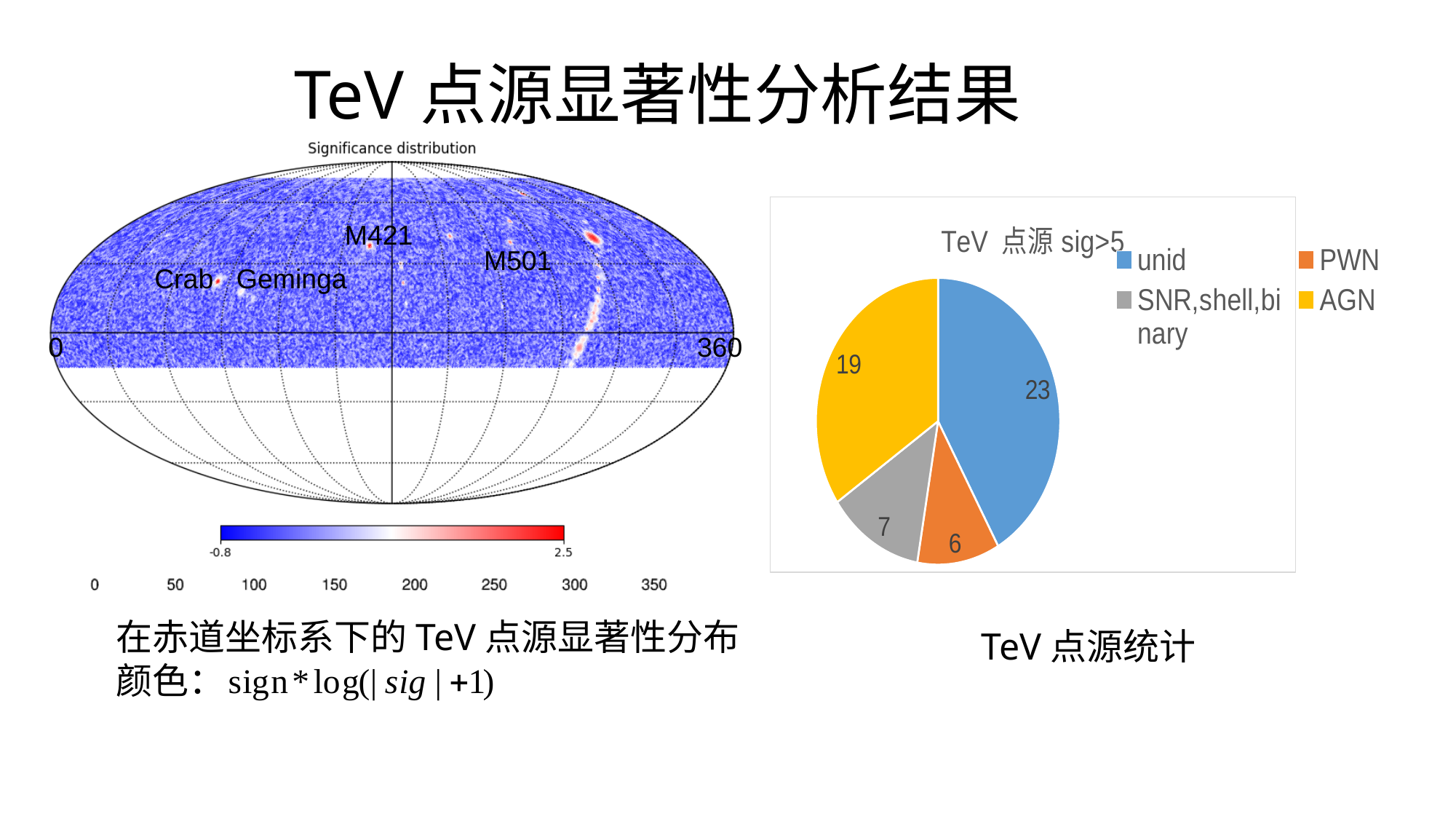
In the pie chart, what is the value for the SNR,shell,binary slice? 7 What is the total of all the values shown in the pie chart? 55 What is the title of the pie chart? TeV 点源 sig>5 In the pie chart, which category has the largest slice? unid What type of chart is shown on the right side of the slide? pie chart How many slices does the pie chart have? 4 In the pie chart, what is the value for the AGN slice? 19 In the pie chart, what is the value for the unid slice? 23 In the pie chart, what is the difference between the unid and AGN values? 4 In the pie chart, what is the value for the PWN slice? 6 In the pie chart, which category has the smallest slice? PWN In the pie chart, which is larger, the SNR,shell,binary slice or the PWN slice? SNR,shell,binary